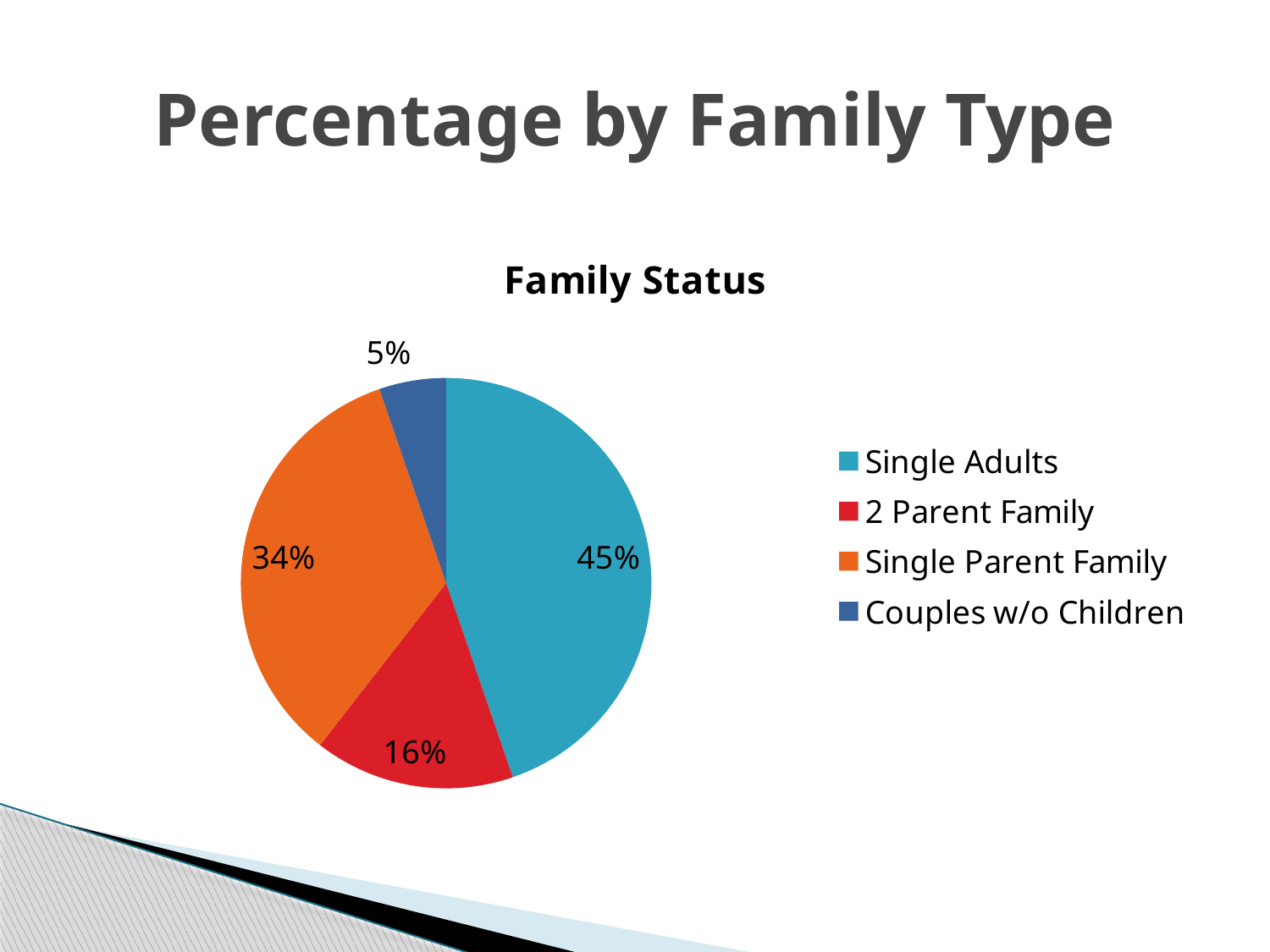
How many slices does the pie chart have? 4 What colour is the Single Parent Family slice? orange Which family type has the smallest share of the pie? Couples w/o Children Which family type has the largest share of the pie? Single Adults Which is larger, the share for 2 Parent Family or the share for Couples w/o Children? 2 Parent Family What percentage of the pie is Single Parent Family? 34% What is the difference in percentage points between Single Adults and Single Parent Family? 11 What is the chart's title? Family Status What percentage of the pie is Couples w/o Children? 5% What percentage of the pie is Single Adults? 45% What kind of chart is shown on the slide? pie chart What percentage of the pie is 2 Parent Family? 16%